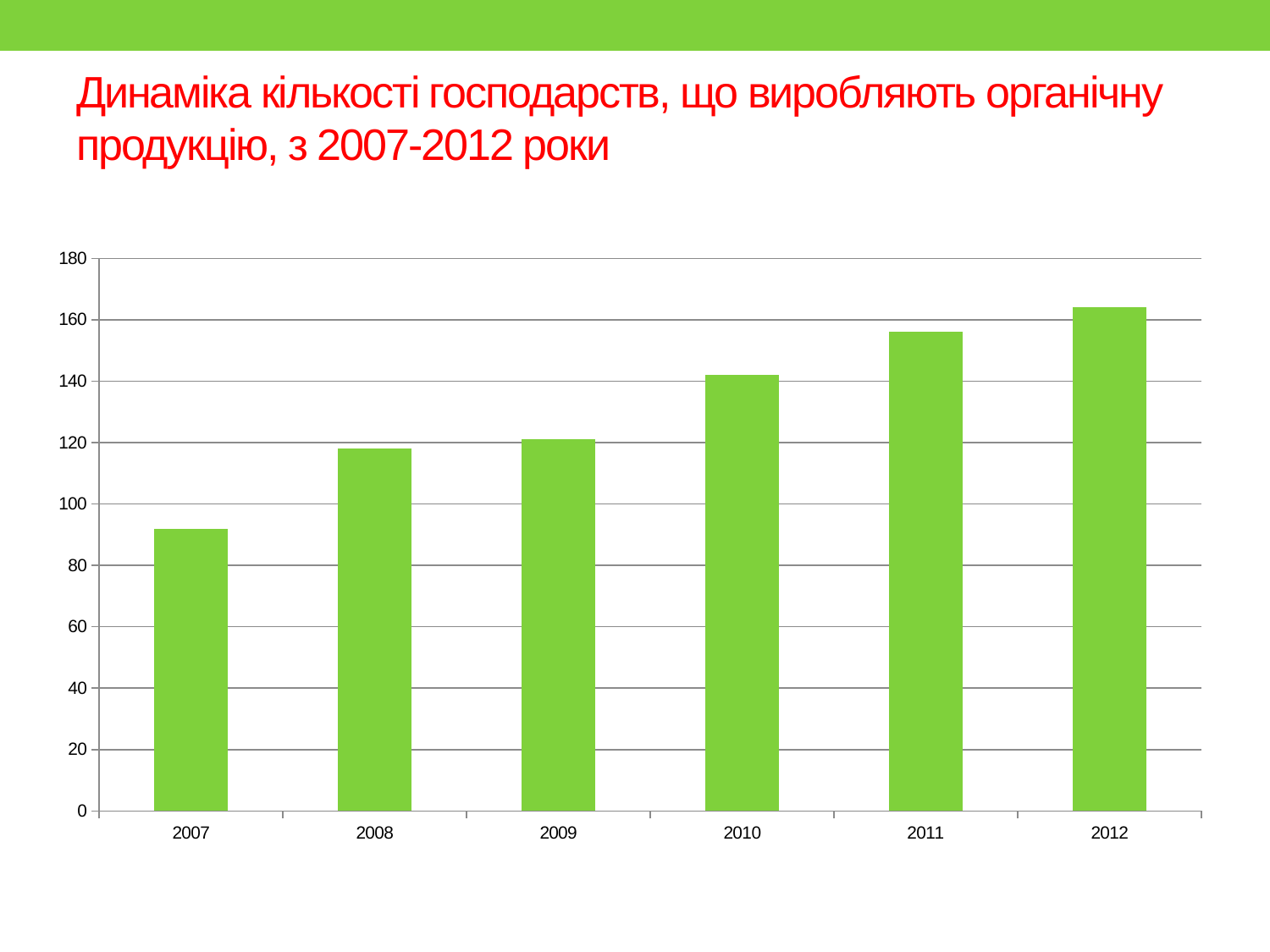
Is the value for 2007 greater or less than 100? less What colour are the bars in the chart? green Which year has the lowest bar in the chart? 2007 Do the values rise or fall from 2007 to 2012? rise What kind of chart is shown on the slide? bar chart Is the value for 2009 greater or less than 140? less Is the value for 2008 greater or less than 100? greater Which year has the highest bar in the chart? 2012 Which is larger, the value for 2010 or the value for 2008? 2010 How many years are shown on the x axis of the chart? 6